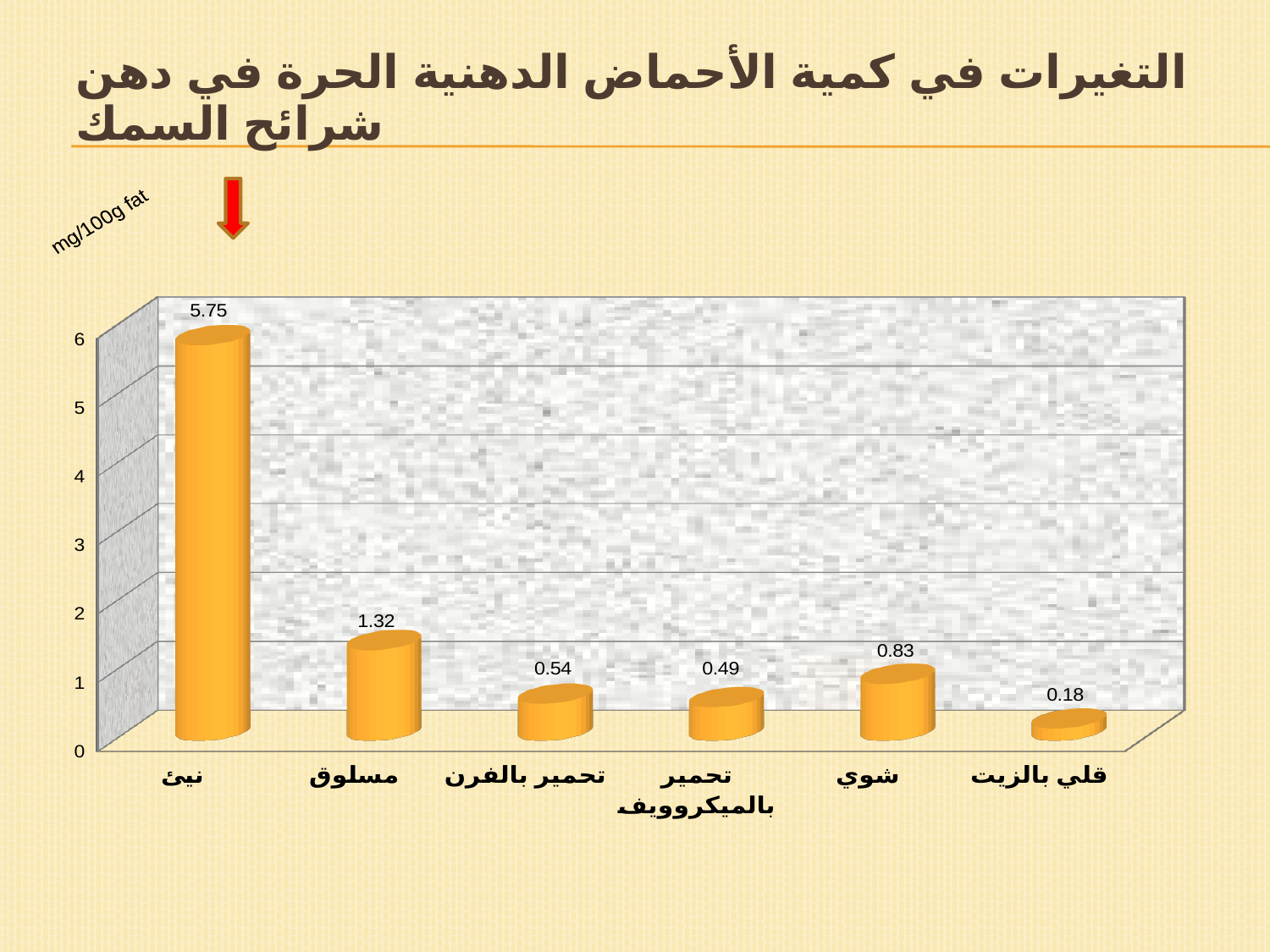
What is the value for مسلوق? 1.32 Which category has the highest value? نيئ What unit is shown for the values on the chart? mg/100g fat What is the value for نيئ? 5.75 Which is larger, the value for تحمير بالفرن or the value for تحمير بالميكروويف? تحمير بالفرن What kind of chart is shown on the slide? bar chart What is the value for شوي? 0.83 What is the difference between the values for شوي and قلي بالزيت? 0.65 What is the difference between the values for نيئ and مسلوق? 4.43 How many categories are shown on the x axis? 6 What is the value for قلي بالزيت? 0.18 Which category has the lowest value? قلي بالزيت